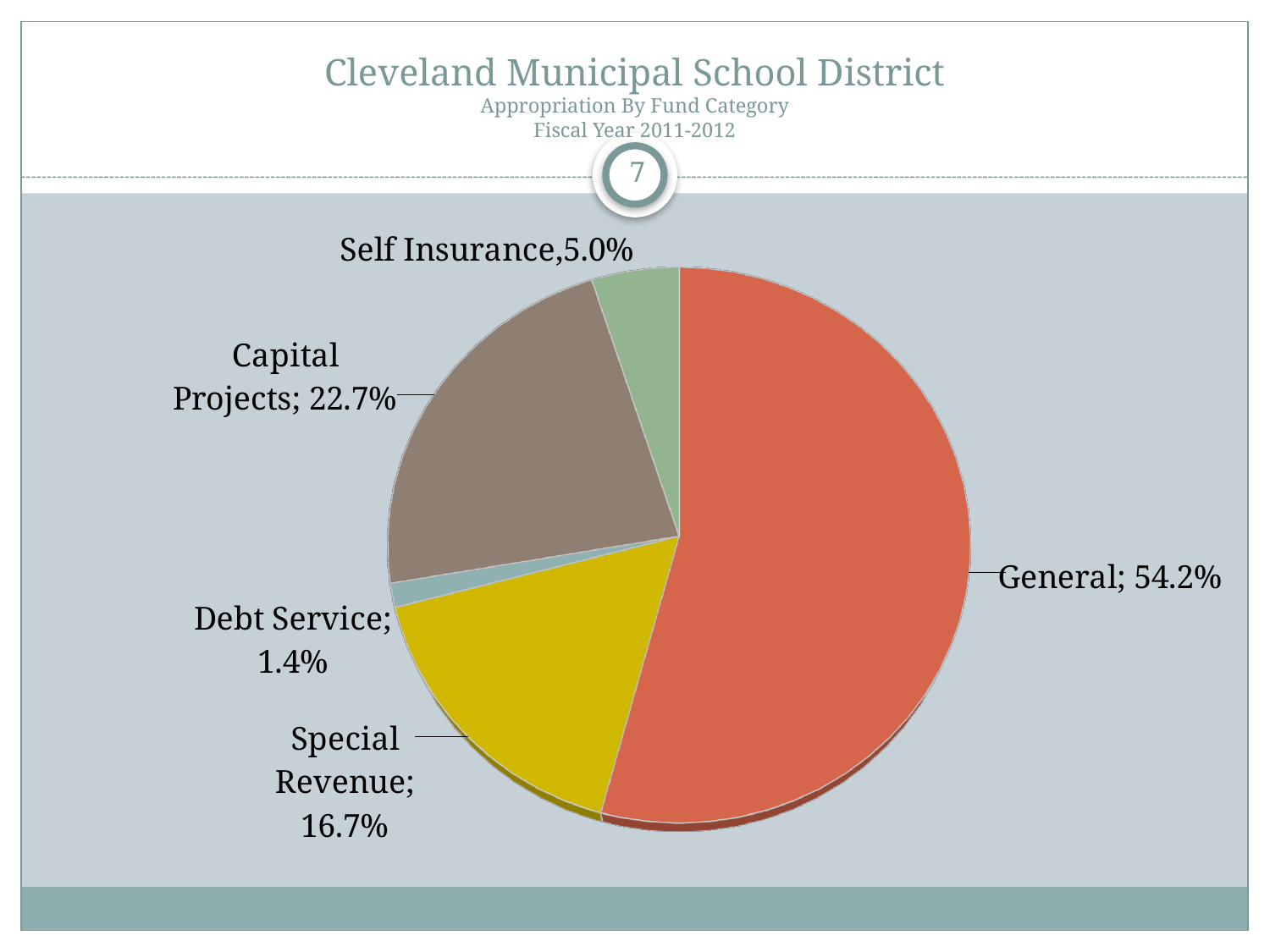
What percentage is shown for Debt Service? 1.4% What is the difference in percentage points between Capital Projects and Special Revenue? 6.0 Which fund category has the smallest share of the pie? Debt Service What percentage is shown for Special Revenue? 16.7% Which is larger, the share for Self Insurance or the share for Debt Service? Self Insurance What percentage is shown for Self Insurance? 5.0% How many fund categories are shown in the pie chart? 5 What kind of chart is shown on the slide? Pie chart Which fund category has the largest share of the pie? General What percentage is shown for Capital Projects? 22.7% What share of the appropriation goes to the General fund category? 54.2% Which fiscal year does the chart cover? Fiscal Year 2011-2012